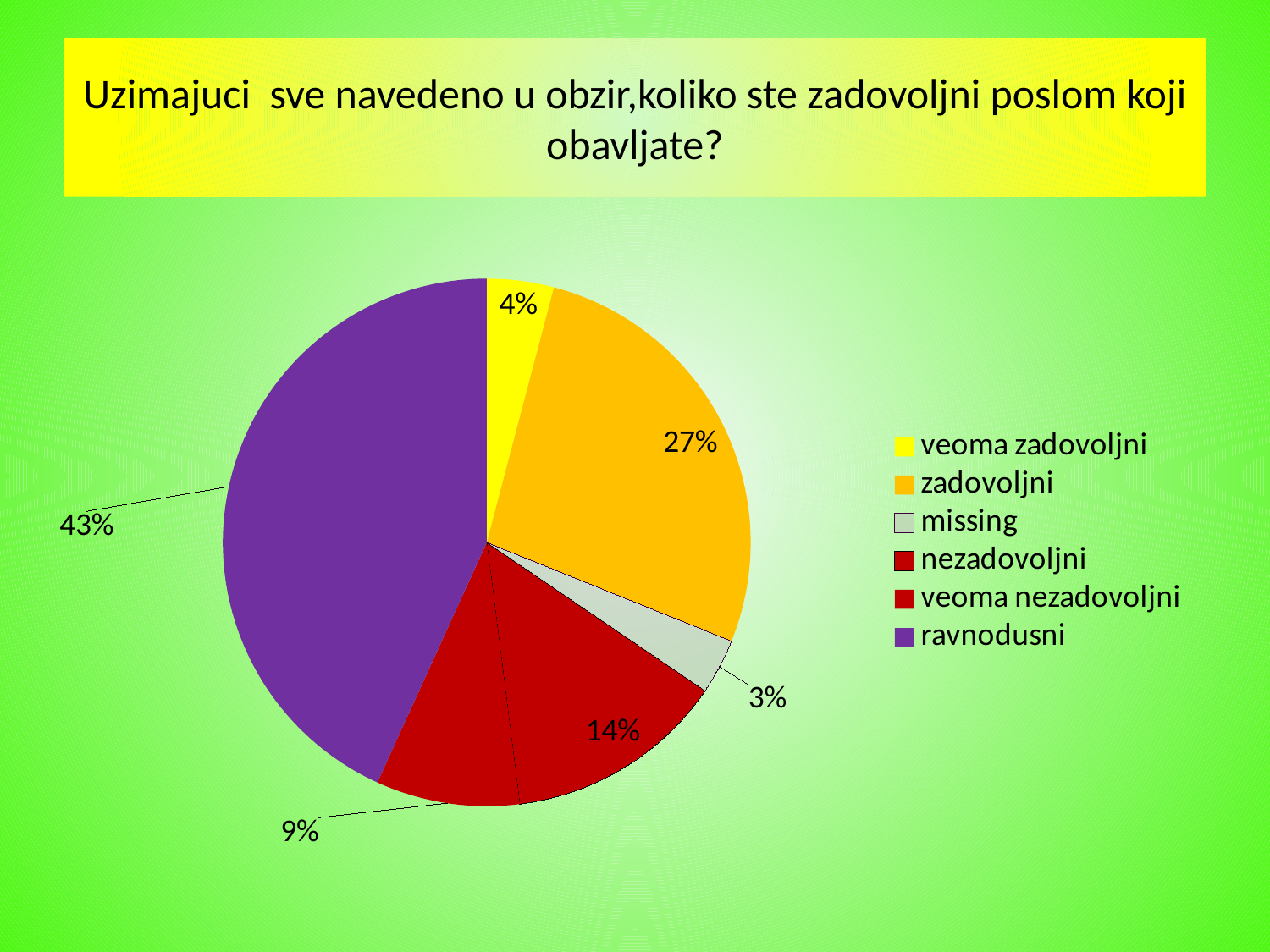
Which is larger, the slice for 'nezadovoljni' or the slice for 'veoma nezadovoljni'? nezadovoljni What percentage is shown for the 'missing' slice? 3% Which category has the smallest slice of the pie? missing What percentage is shown for 'veoma nezadovoljni'? 9% What percentage is shown for 'veoma zadovoljni'? 4% How many categories does the legend list? 6 What is the difference in percentage points between 'ravnodusni' and 'zadovoljni'? 16 Which category has the largest slice of the pie? ravnodusni What percentage is shown for 'zadovoljni'? 27% What type of chart is shown on the slide? pie chart What percentage is shown for 'nezadovoljni'? 14% What share of the pie is labelled for the 'ravnodusni' slice? 43%